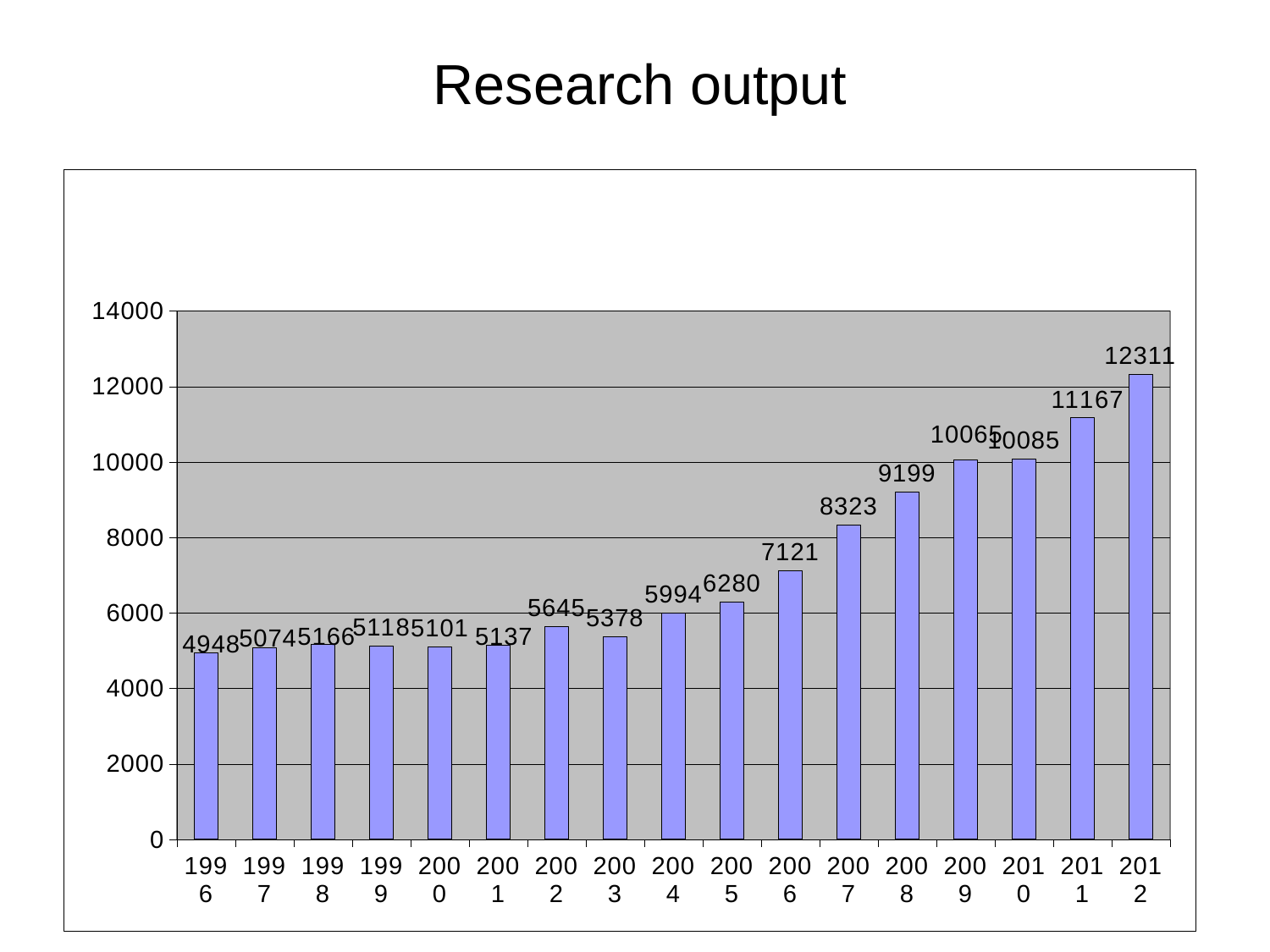
Do the research output values generally rise or fall from 1996 to 2012? Rise What is the research output value for 1996? 4948 Which year has the highest research output? 2012 What kind of chart is shown on the slide? Bar chart What is the difference between the research output in 2012 and in 2011? 1144 How many years are shown on the x axis? 17 What is the research output value for 2012? 12311 What is the research output value for 2007? 8323 What is the research output value for 2002? 5645 Is the value for 2008 greater or less than 8000? greater Which year has the larger research output, 2002 or 2003? 2002 Which year has the lowest research output? 1996